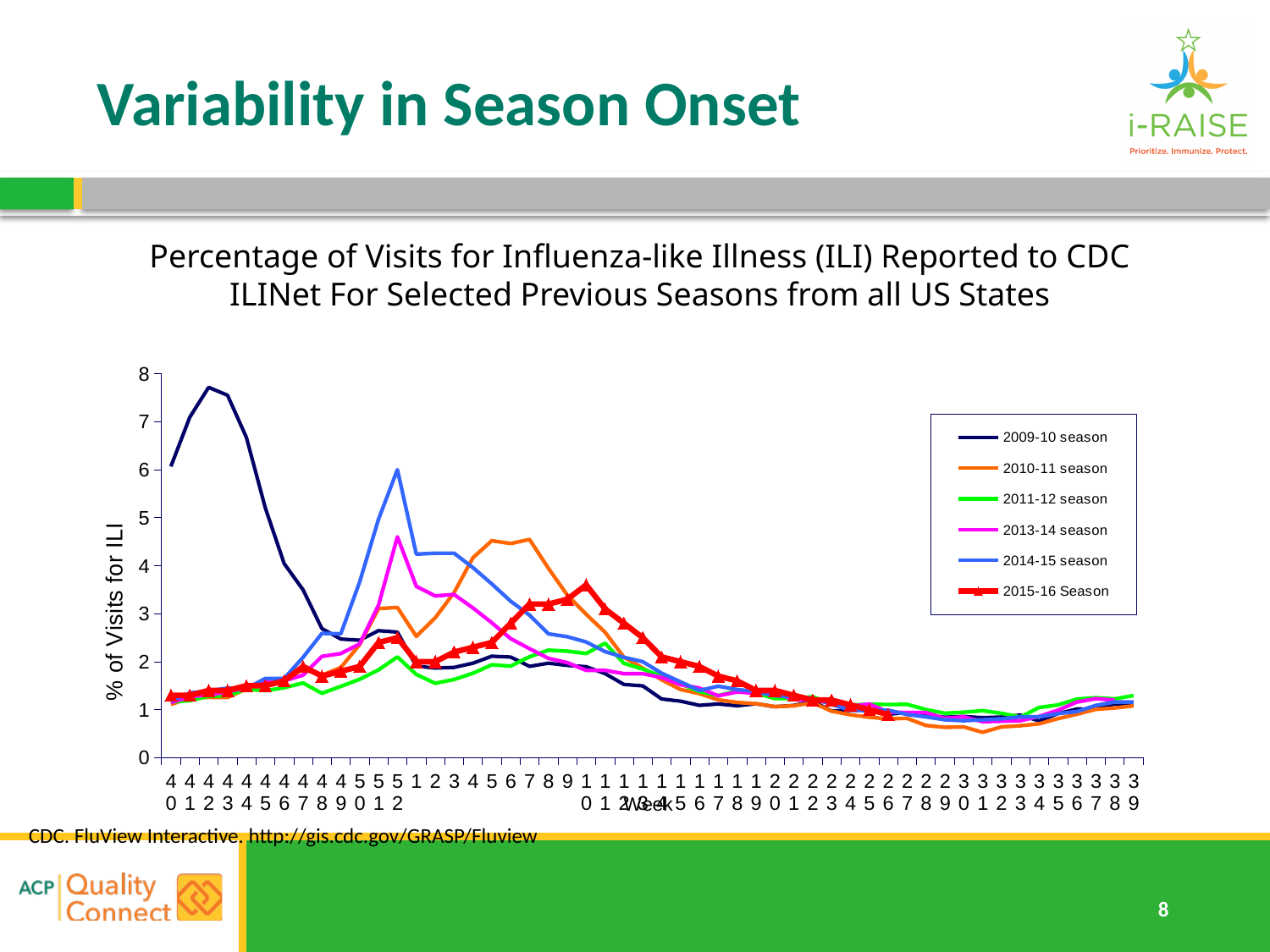
What is the label on the vertical axis of the chart? % of Visits for ILI Which peaks higher, the 2009-10 season or the 2010-11 season? 2009-10 season Is the peak value for the 2014-15 season greater or less than 5? greater Is the peak value for the 2013-14 season greater or less than 4? greater Is the peak value for the 2009-10 season greater or less than 7? greater Does the 2009-10 season line rise or fall between week 42 and week 50? fall Which season reaches the highest percentage of visits for ILI on the chart? 2009-10 season How many seasons does the legend list? 6 Which season has the lowest peak percentage of visits for ILI? 2011-12 season What kind of chart is shown on the slide? line chart